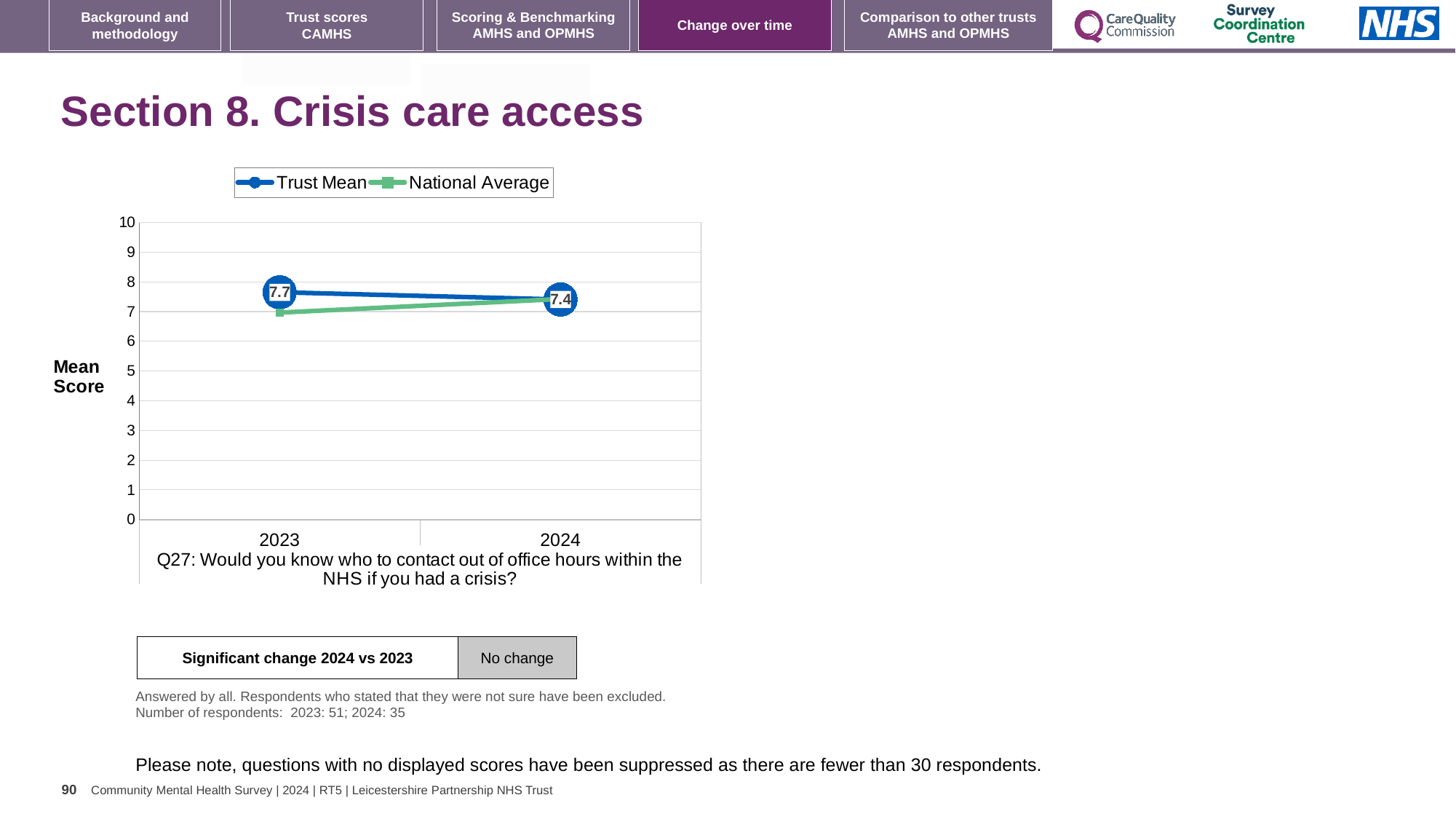
Is the National Average value for 2024 greater or less than 8? less What is the difference between the Trust Mean scores for 2023 and 2024? 0.3 In 2023, which is higher: the Trust Mean or the National Average? Trust Mean How many years are shown on the x axis? 2 What is the Trust Mean score for 2024? 7.4 What is the Trust Mean score for 2023? 7.7 What kind of chart is shown? Line chart Is the National Average value for 2023 greater or less than 6? greater In which year is the Trust Mean score lowest? 2024 In which year is the Trust Mean score highest? 2023 Does the Trust Mean rise or fall from 2023 to 2024? Fall How many series does the legend list? 2